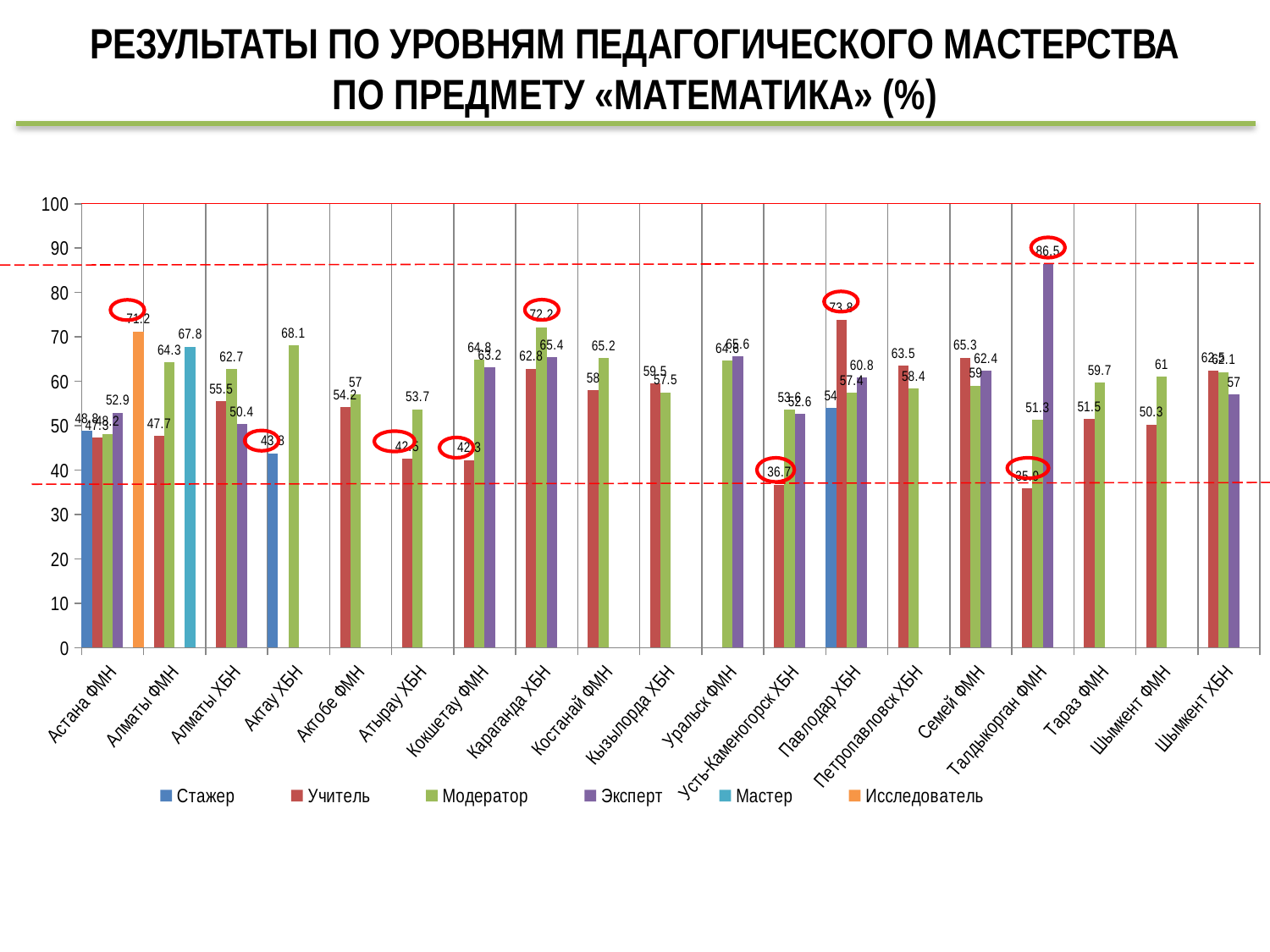
Which category has the lowest value for Учитель? Талдыкорган ФМН Which is larger in Усть-Каменогорск ХБН: the Модератор value or the Учитель value? Модератор What is the value for Мастер in Алматы ФМН? 67.8 Which series is shown in orange in the legend? Исследователь How many categories (cities/schools) are shown on the x axis? 19 What is the value for Учитель in Павлодар ХБН? 73.8 What is the value for Эксперт in Талдыкорган ФМН? 86.5 How many series does the legend list? 6 What is the value for Исследователь in Астана ФМН? 71.2 What is the difference between the Модератор value and the Учитель value in Караганда ХБН? 9.4 What kind of chart is shown on the slide? bar chart Which category has the highest value for Эксперт? Талдыкорган ФМН